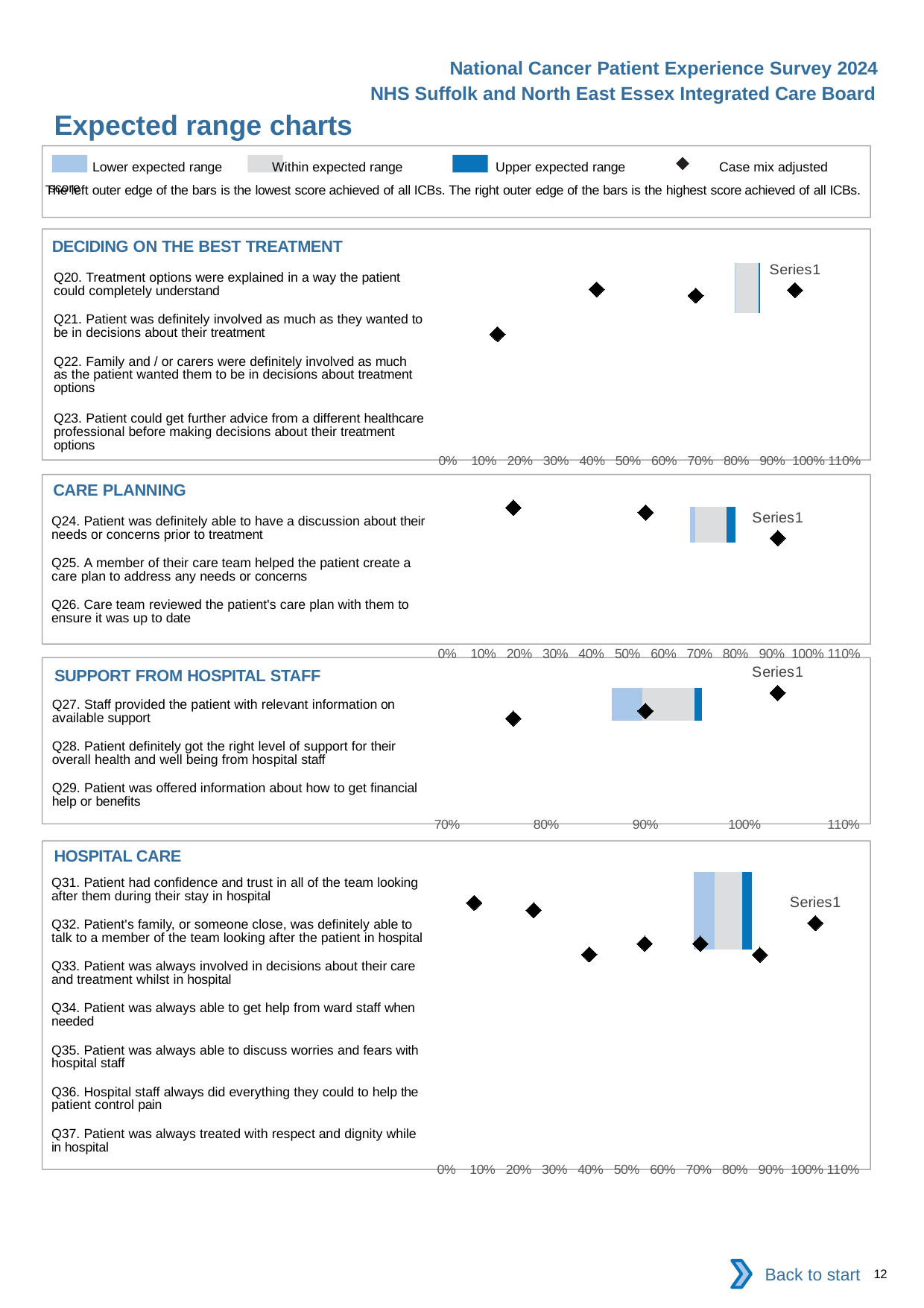
What kind of chart is used in the DECIDING ON THE BEST TREATMENT section? bar chart What is the highest axis tick shown on the HOSPITAL CARE chart? 110% In the DECIDING ON THE BEST TREATMENT chart, is the rightmost diamond marker greater or less than 80%? greater In the HOSPITAL CARE chart, is the leftmost diamond marker greater or less than 20%? less How many survey questions are listed in the HOSPITAL CARE chart? 7 How many survey questions are listed in the CARE PLANNING chart? 3 How many charts are shown on the slide? 4 How many entries does the legend at the top of the slide list? 4 What is the lowest axis tick shown on the SUPPORT FROM HOSPITAL STAFF chart? 70%